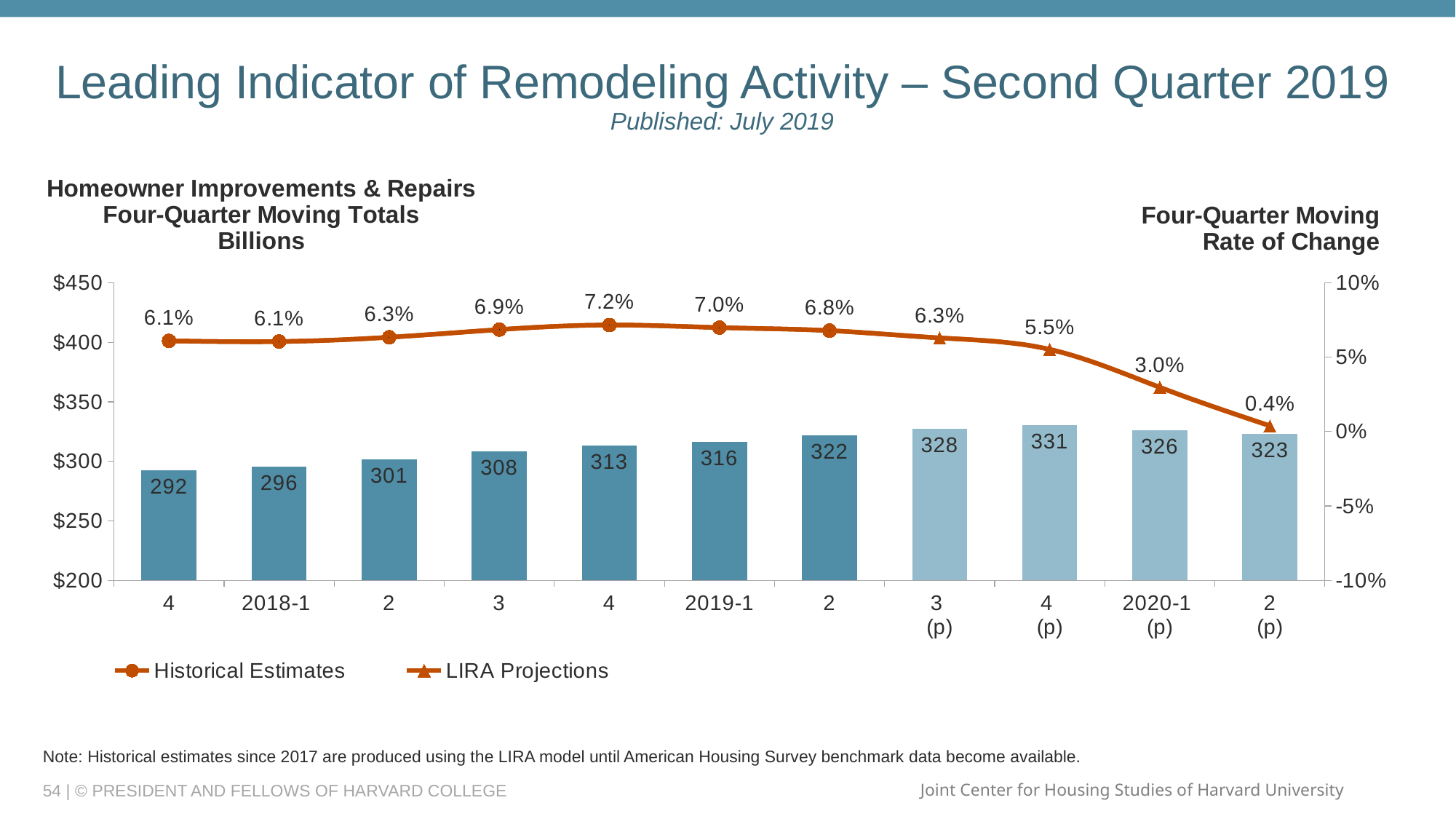
What is the lowest four-quarter moving rate of change shown on the line? 0.4% What is the four-quarter moving total (in billions) for 2019-1? 316 What is the lowest four-quarter moving total shown on the chart? 292 How many series does the legend list? 2 What is the difference between the highest bar (331) and the lowest bar (292)? 39 Which period has the highest four-quarter moving total bar? 4 (p) What is the four-quarter moving total for 2018-1? 296 What is the four-quarter moving rate of change projected for 2020-1 (p)? 3.0% How many periods are shown along the x axis? 11 Which has the larger four-quarter moving total, 2020-1 (p) or 2 (p)? 2020-1 (p) What is the four-quarter moving rate of change for 2019-1? 7.0% What is the highest four-quarter moving rate of change shown on the line? 7.2%